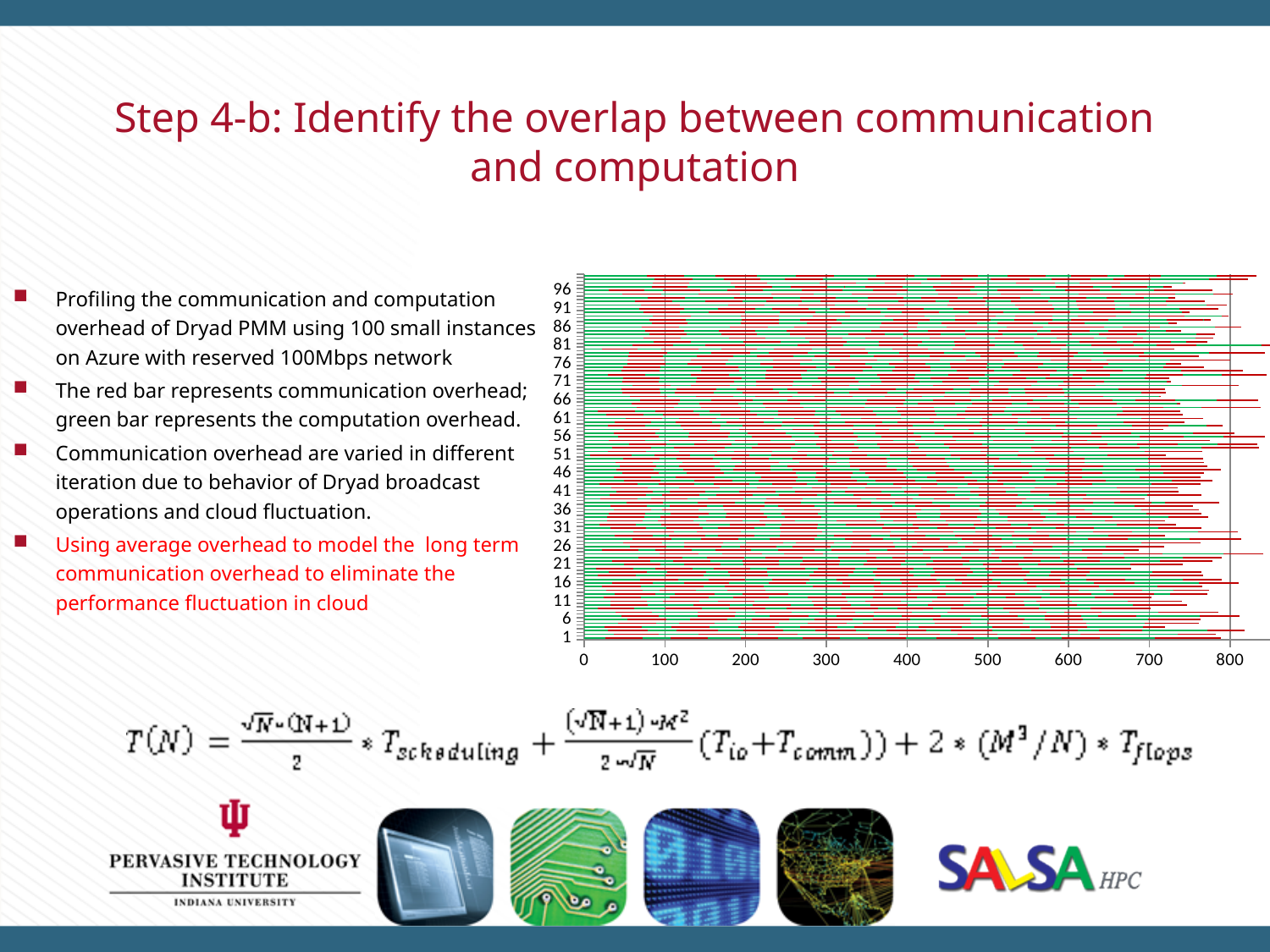
What two colours are used for the bars in the chart? red and green What is the highest label shown on the y axis of the chart? 96 What is the highest value labelled on the x axis of the chart? 800 What kind of chart is shown on the slide? bar chart Is the value for iteration 1 greater or less than 300? greater Is the value for iteration 96 greater or less than 400? greater